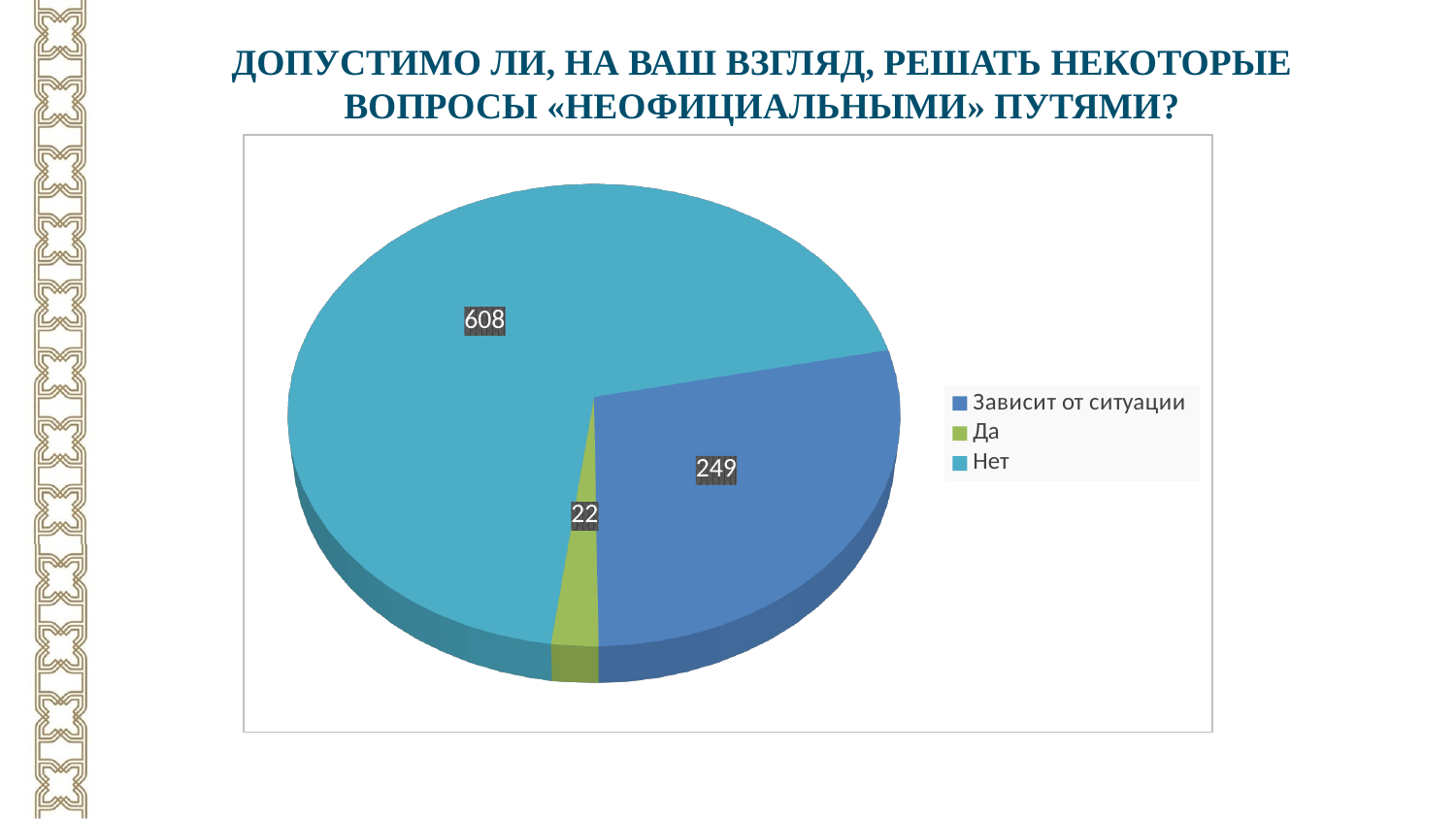
What is the value for "Да"? 22 What is the difference between the values for "Зависит от ситуации" and "Да"? 227 What is the value for "Зависит от ситуации"? 249 What is the total of all slices in the pie chart? 879 Which colour represents "Да" in the legend? Green Which category has the largest slice? Нет What is the difference between the values for "Нет" and "Зависит от ситуации"? 359 How many categories does the pie chart have? 3 What is the value for "Нет"? 608 What kind of chart is shown on the slide? Pie chart Which category has the smallest slice? Да Which is larger, the value for "Зависит от ситуации" or the value for "Да"? Зависит от ситуации